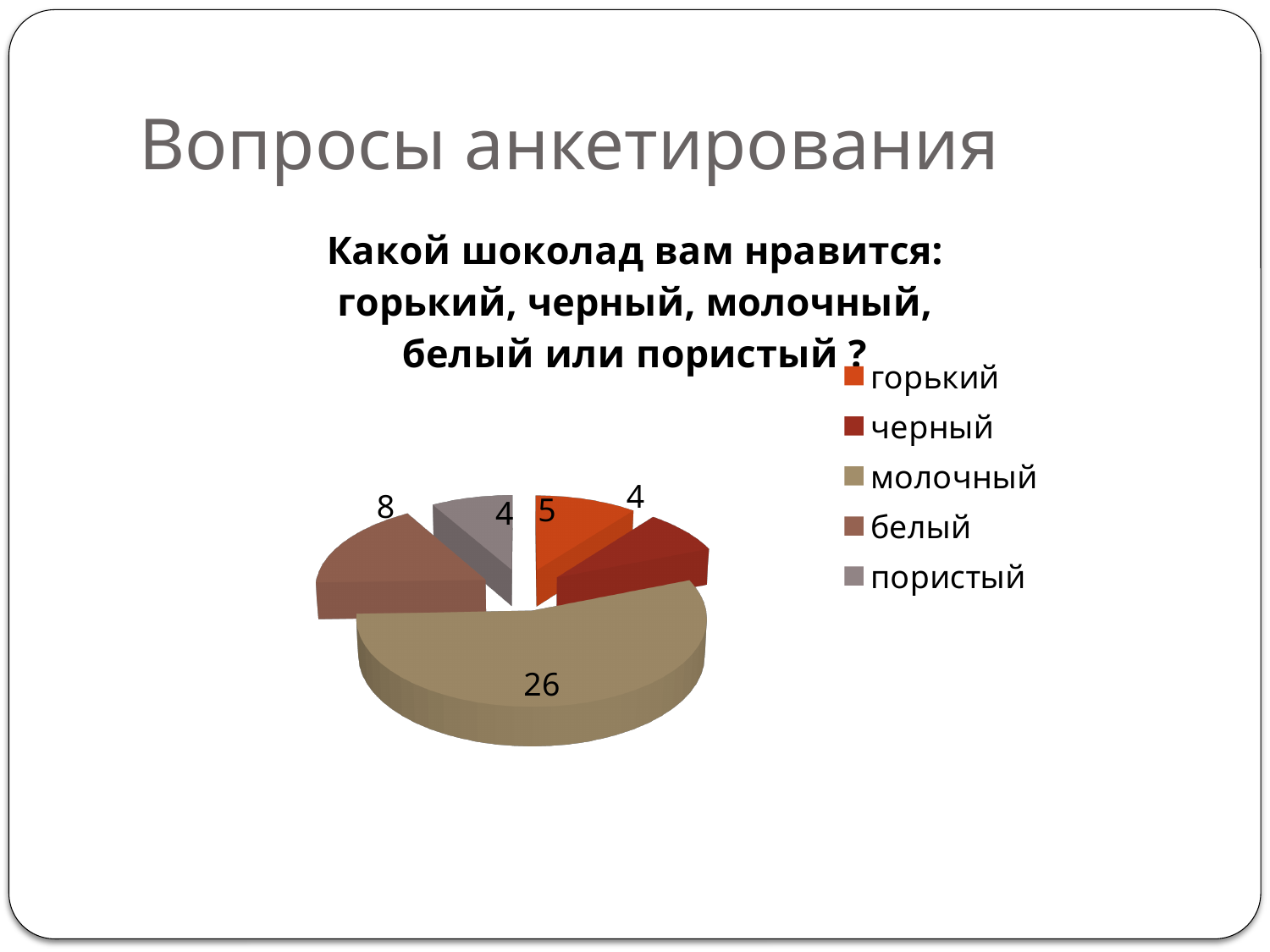
What type of chart is shown on the slide? pie chart What is the value for черный in the pie chart? 4 What is the value for белый in the pie chart? 8 Which legend entry is shown in orange in the pie chart? горький What is the value for молочный in the pie chart? 26 What is the difference between the values for молочный and белый? 18 Which is larger, the value for белый or the value for горький? белый What is the value for пористый in the pie chart? 4 What is the value for горький in the pie chart? 5 How many categories does the legend of the pie chart list? 5 Which category has the largest slice in the pie chart? молочный What is the sum of all the values shown in the pie chart? 47